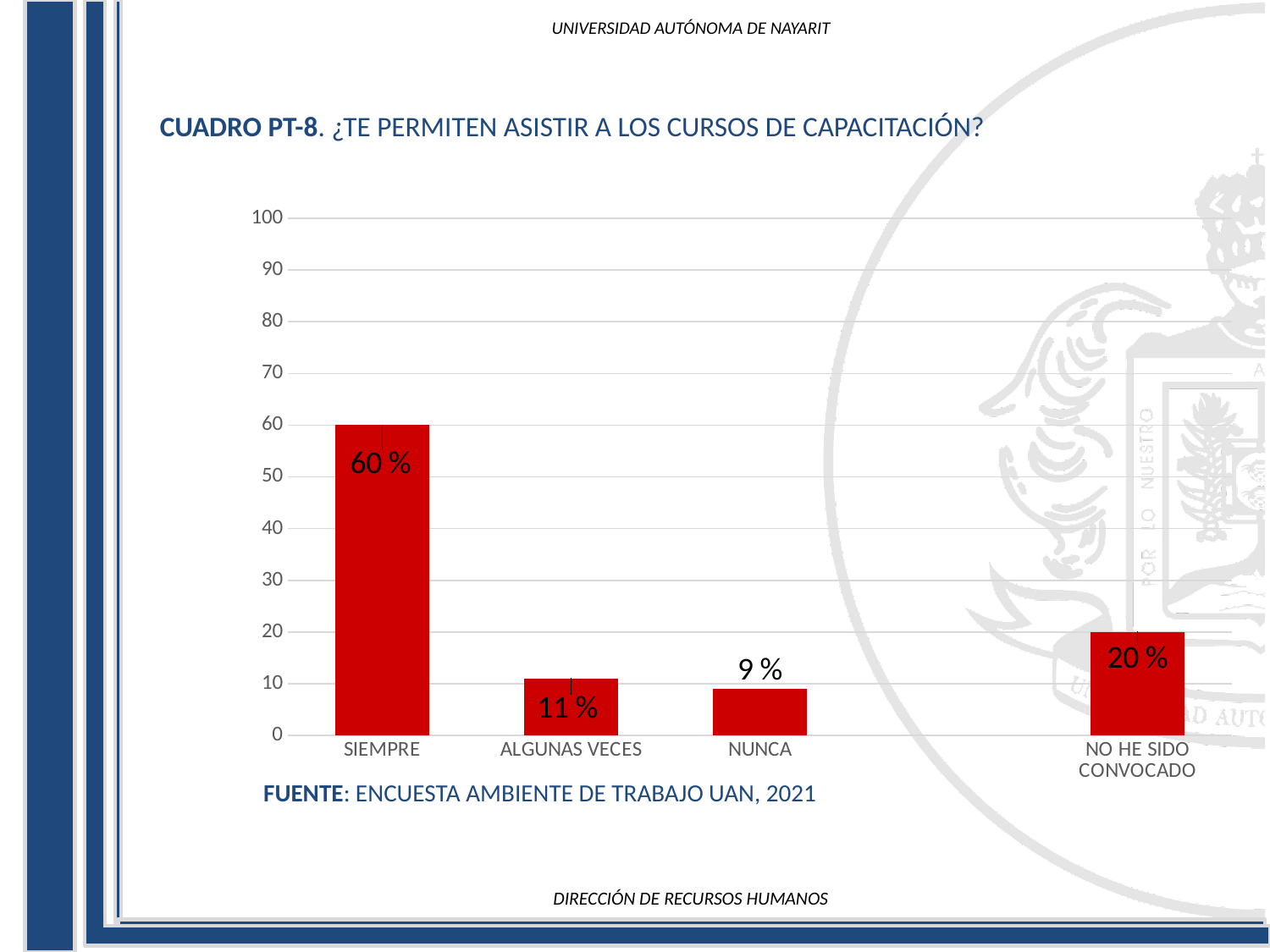
How many categories are shown on the x axis? 4 Is the value for SIEMPRE greater or less than 50? greater What is the value for NO HE SIDO CONVOCADO? 20 % Which category has the lowest value? NUNCA Which is larger, the value for ALGUNAS VECES or the value for NO HE SIDO CONVOCADO? NO HE SIDO CONVOCADO What is the source cited below the chart? ENCUESTA AMBIENTE DE TRABAJO UAN, 2021 What is the value for SIEMPRE? 60 % What is the value for NUNCA? 9 % What is the value for ALGUNAS VECES? 11 % What kind of chart is shown on the slide? bar chart Which category has the highest value? SIEMPRE What is the difference between the values for SIEMPRE and NO HE SIDO CONVOCADO? 40 %